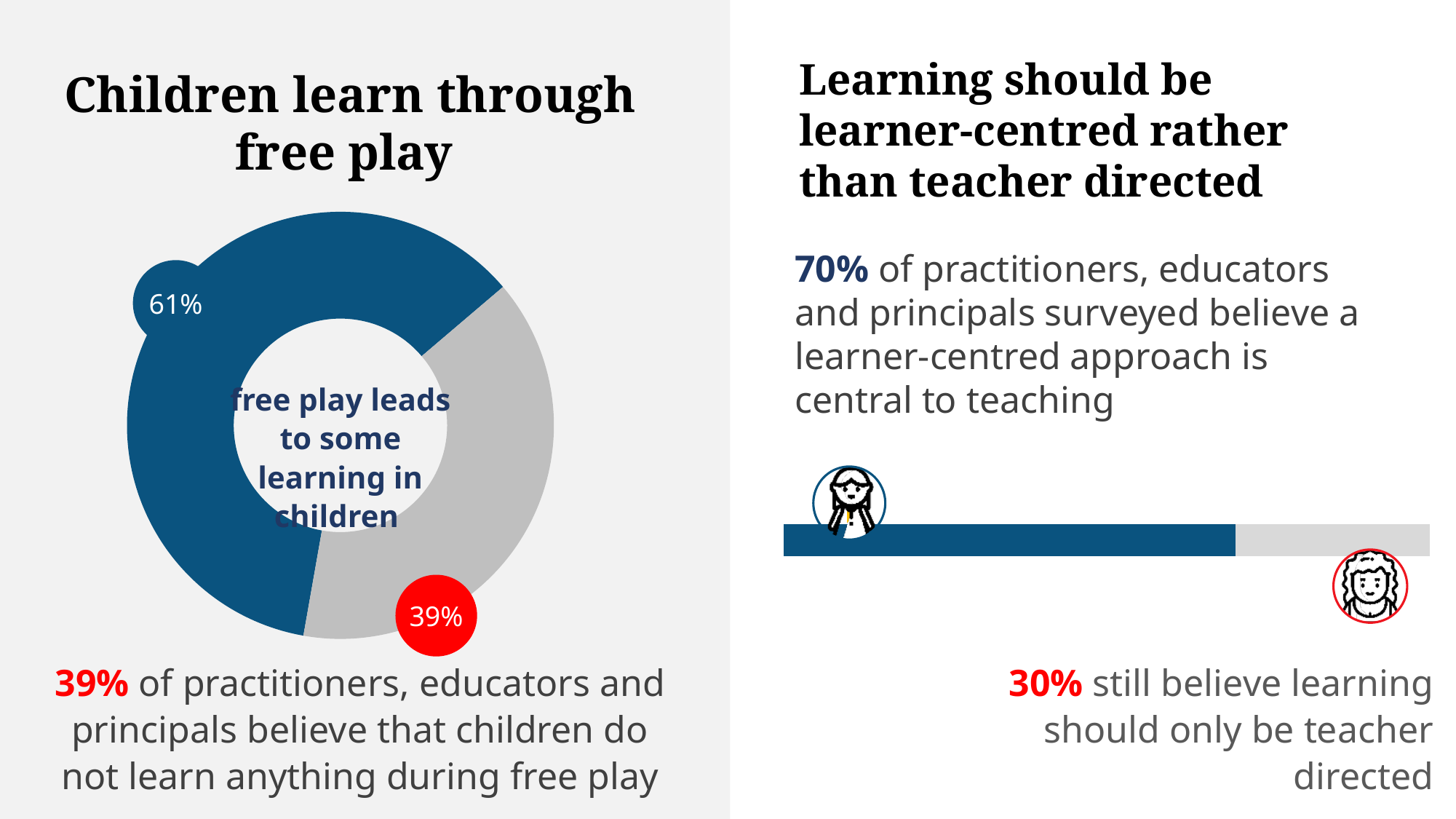
In the "Children learn through free play" chart, do the two labelled shares add up to 100%? Yes, 100% In the "Children learn through free play" chart, what is the difference between the two labelled shares? 22 percentage points In the "Children learn through free play" chart, what colour is the 39% segment? grey What kind of chart is shown under the title "Children learn through free play"? donut (pie) chart In the "Children learn through free play" chart, what is the largest share shown? 61% In the bar under "Learning should be learner-centred rather than teacher directed", what percentage does the grey portion represent? 30% In the "Children learn through free play" chart, what percentage is labelled on the blue segment? 61% In the "Children learn through free play" chart, what percentage is labelled on the grey segment? 39% In the bar under "Learning should be learner-centred rather than teacher directed", what percentage does the blue portion represent? 70% What text is written in the centre of the "Children learn through free play" donut chart? free play leads to some learning in children In the "Children learn through free play" chart, which segment is larger, the blue one or the grey one? the blue one How many segments does the "Children learn through free play" donut chart have? 2